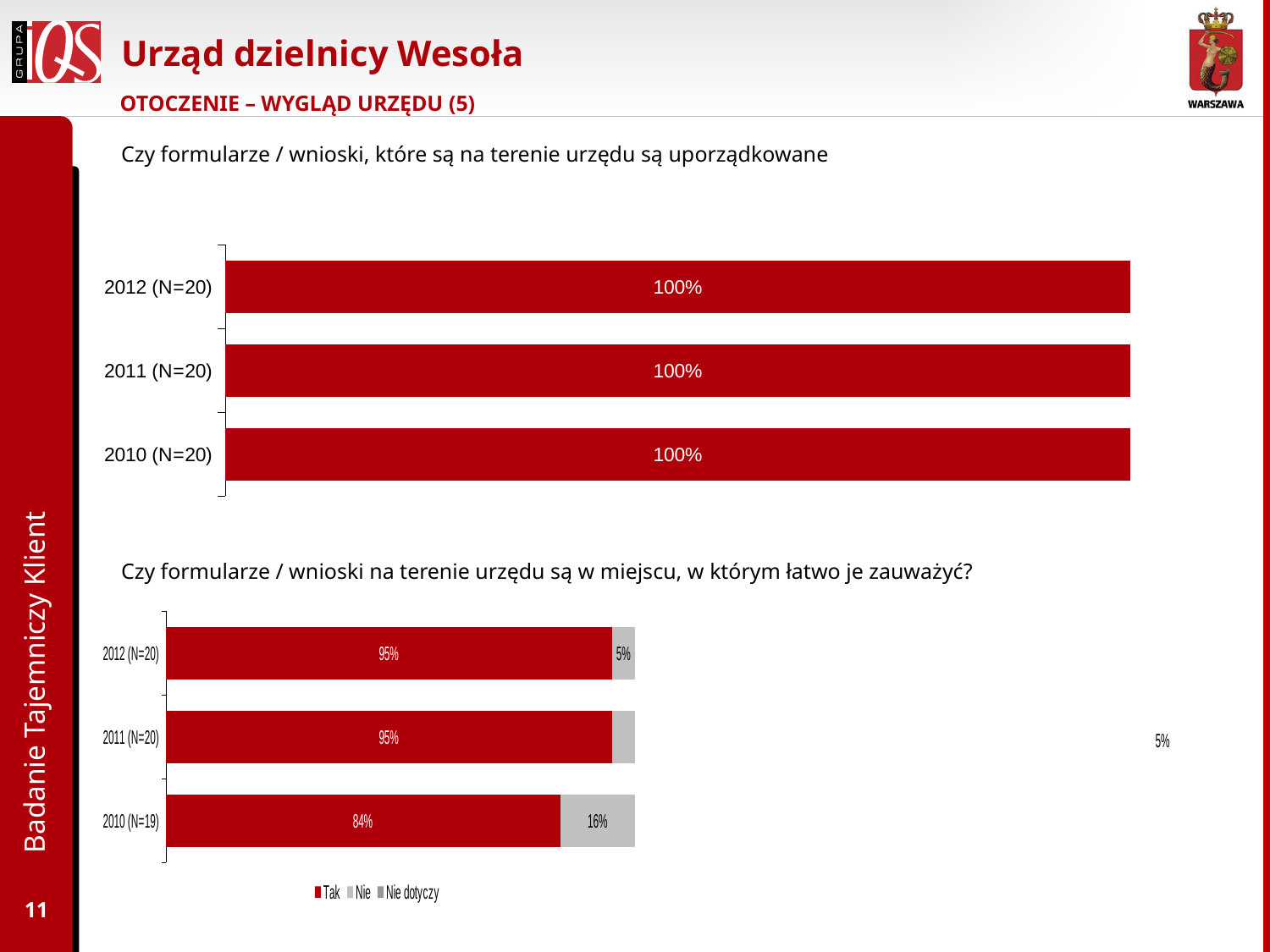
In the bottom chart ("Czy formularze / wnioski na terenie urzędu są w miejscu, w którym łatwo je zauważyć?"), which year has the lowest Tak value? 2010 (N=19) What kind of chart is the top chart ("Czy formularze / wnioski, które są na terenie urzędu są uporządkowane")? bar chart In the bottom chart ("Czy formularze / wnioski na terenie urzędu są w miejscu, w którym łatwo je zauważyć?"), what is the Tak value for 2010 (N=19)? 84% In the top chart ("Czy formularze / wnioski, które są na terenie urzędu są uporządkowane"), how many categories are shown? 3 In the bottom chart ("Czy formularze / wnioski na terenie urzędu są w miejscu, w którym łatwo je zauważyć?"), what is the Tak value for 2012 (N=20)? 95% In the bottom chart ("Czy formularze / wnioski na terenie urzędu są w miejscu, w którym łatwo je zauważyć?"), what is the Nie value for 2010 (N=19)? 16% In the bottom chart ("Czy formularze / wnioski na terenie urzędu są w miejscu, w którym łatwo je zauważyć?"), what is the Nie value for 2012 (N=20)? 5% In the bottom chart ("Czy formularze / wnioski na terenie urzędu są w miejscu, w którym łatwo je zauważyć?"), what is the difference between the Tak values for 2012 (N=20) and 2010 (N=19)? 11% In the top chart ("Czy formularze / wnioski, które są na terenie urzędu są uporządkowane"), what is the value for 2010 (N=20)? 100% In the bottom chart ("Czy formularze / wnioski na terenie urzędu są w miejscu, w którym łatwo je zauważyć?"), what are the legend entries? Tak, Nie, Nie dotyczy In the top chart ("Czy formularze / wnioski, które są na terenie urzędu są uporządkowane"), what is the value for 2012 (N=20)? 100% In the bottom chart ("Czy formularze / wnioski na terenie urzędu są w miejscu, w którym łatwo je zauważyć?"), how many series does the legend list? 3